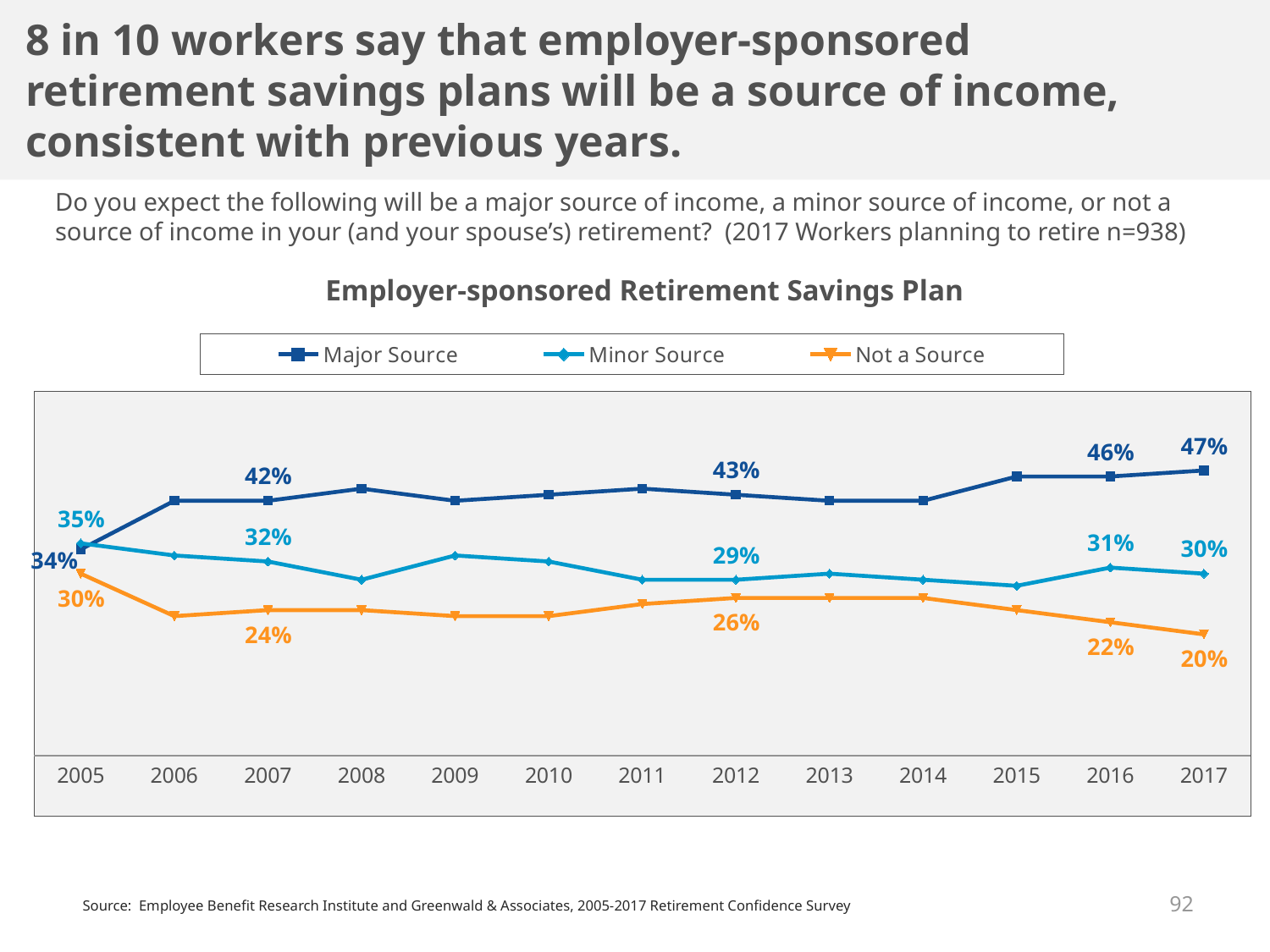
What is the value for Minor Source in 2012? 29% What is the title of the chart? Employer-sponsored Retirement Savings Plan What is the difference between Major Source and Not a Source in 2017? 27 percentage points How many series does the legend list? 3 What is the value for Major Source in 2005? 34% What is the value for Not a Source in 2007? 24% What is the value for Major Source in 2017? 47% Which is larger in 2005, Major Source or Minor Source? Minor Source Among the labelled years, in which year is Not a Source lowest? 2017 Does the Not a Source line rise or fall from 2012 to 2017? Fall How many years are shown on the x axis? 13 What type of chart is shown on the slide? Line chart